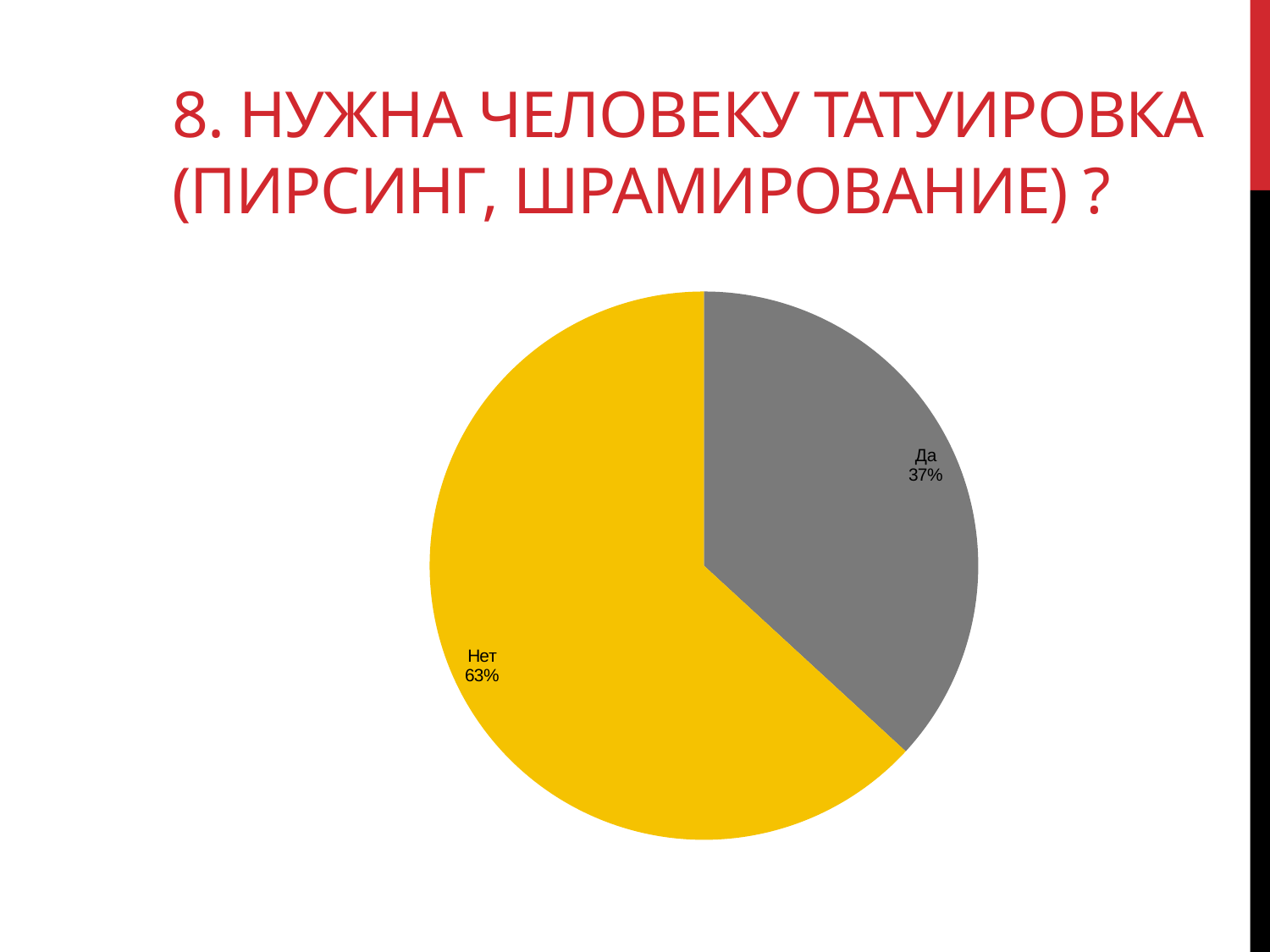
What share of the pie does the "Нет" slice represent? 63% What is the difference in percentage points between the "Нет" and "Да" slices? 26 Is the value for "Да" greater or less than 50%? less What kind of chart is shown on the slide? pie chart How many slices does the pie chart have? 2 What colour is the "Нет" slice? yellow Is the value for "Нет" greater or less than 50%? greater Which is larger, the "Да" slice or the "Нет" slice? Нет Which slice is the largest in the pie chart? Нет What colour is the "Да" slice? grey What share of the pie does the "Да" slice represent? 37% Which slice is the smallest in the pie chart? Да